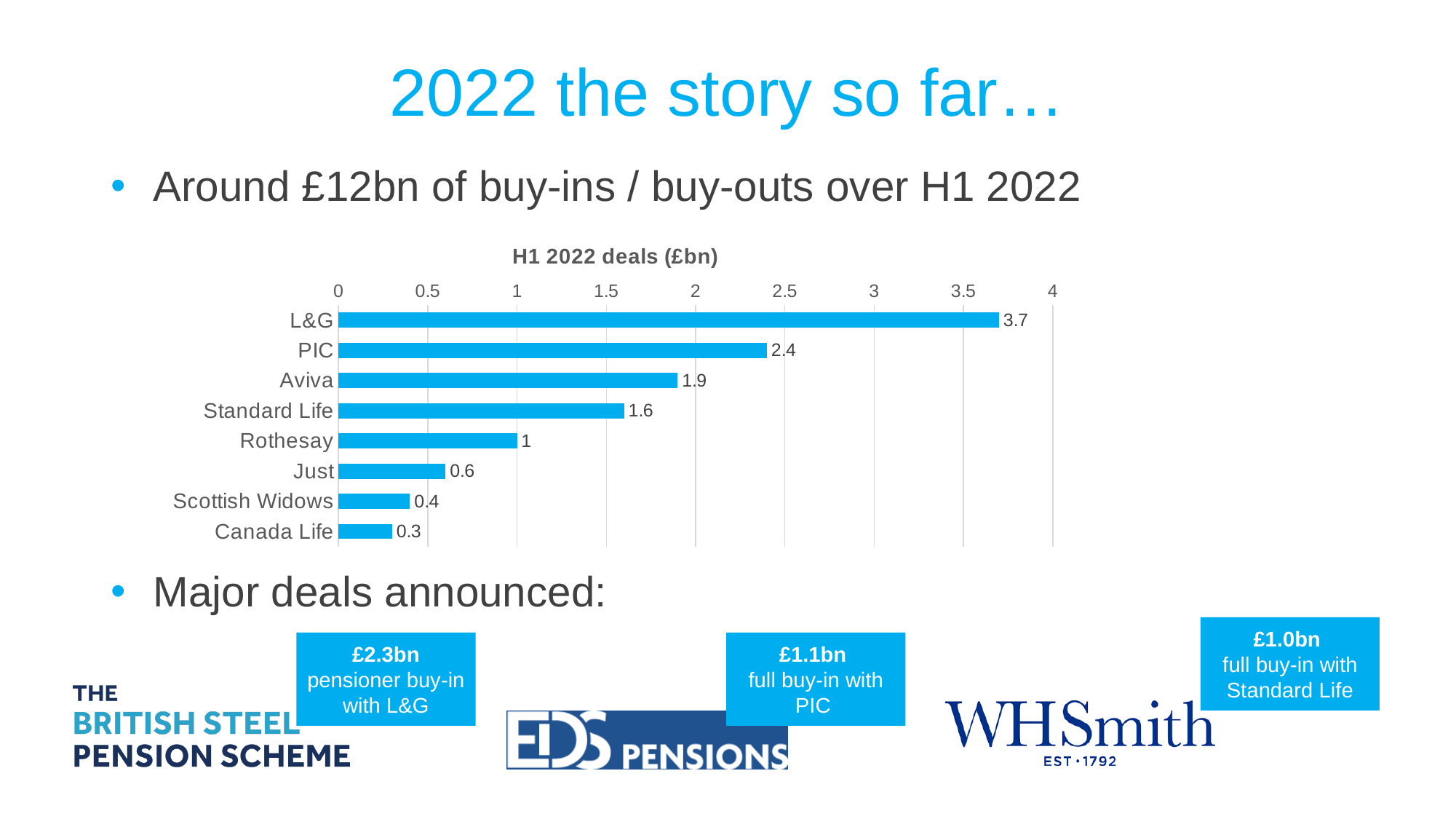
What is the title of the chart on the slide? H1 2022 deals (£bn) Which insurer has the lowest value in the H1 2022 deals chart? Canada Life What is the value for Standard Life in the H1 2022 deals chart? 1.6 Is the value for PIC in the H1 2022 deals chart greater or less than 2? greater What kind of chart is the H1 2022 deals chart? Bar chart What is the difference between the values for Aviva and Rothesay in the H1 2022 deals chart? 0.9 What is the value for L&G in the H1 2022 deals chart? 3.7 What is the value for Scottish Widows in the H1 2022 deals chart? 0.4 Which insurer has the highest value in the H1 2022 deals chart? L&G Which has a larger value in the H1 2022 deals chart, Aviva or Standard Life? Aviva How many insurers are shown in the H1 2022 deals chart? 8 What is the difference between the values for L&G and PIC in the H1 2022 deals chart? 1.3